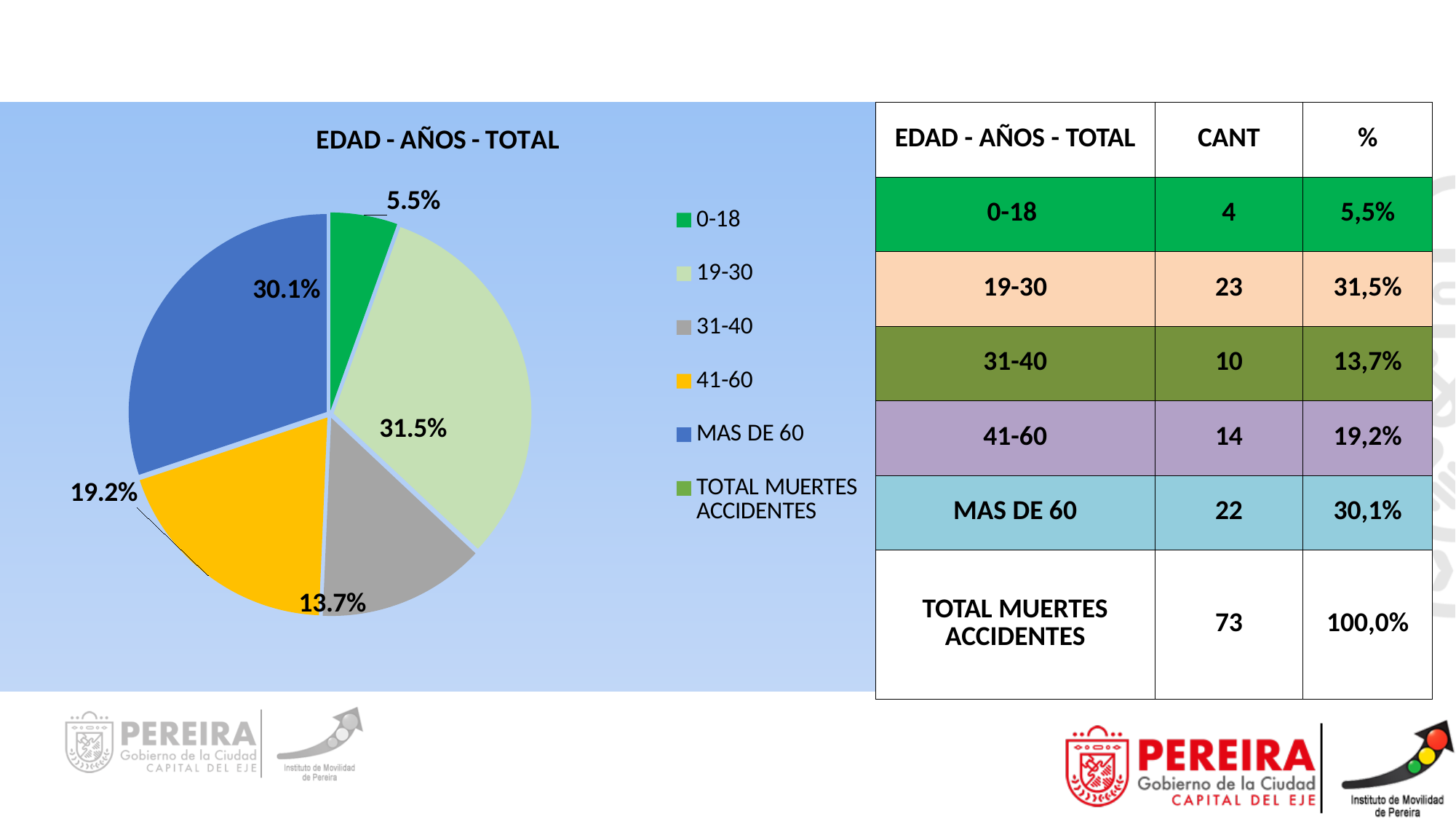
Which slice is larger in the pie chart, 41-60 or 31-40? 41-60 How many entries does the pie chart's legend list? 6 What percentage does the 0-18 slice show in the pie chart? 5.5% Which age group has the smallest slice in the pie chart? 0-18 What type of chart is shown on the slide? pie chart How many slices are plotted in the pie chart? 5 What percentage does the MAS DE 60 slice show in the pie chart? 30.1% What percentage does the 31-40 slice show in the pie chart? 13.7% What is the title of the pie chart? EDAD - AÑOS - TOTAL What is the difference in percentage points between the 19-30 slice and the MAS DE 60 slice? 1.4% What percentage does the 19-30 slice show in the pie chart? 31.5% Which age group has the largest slice in the pie chart? 19-30